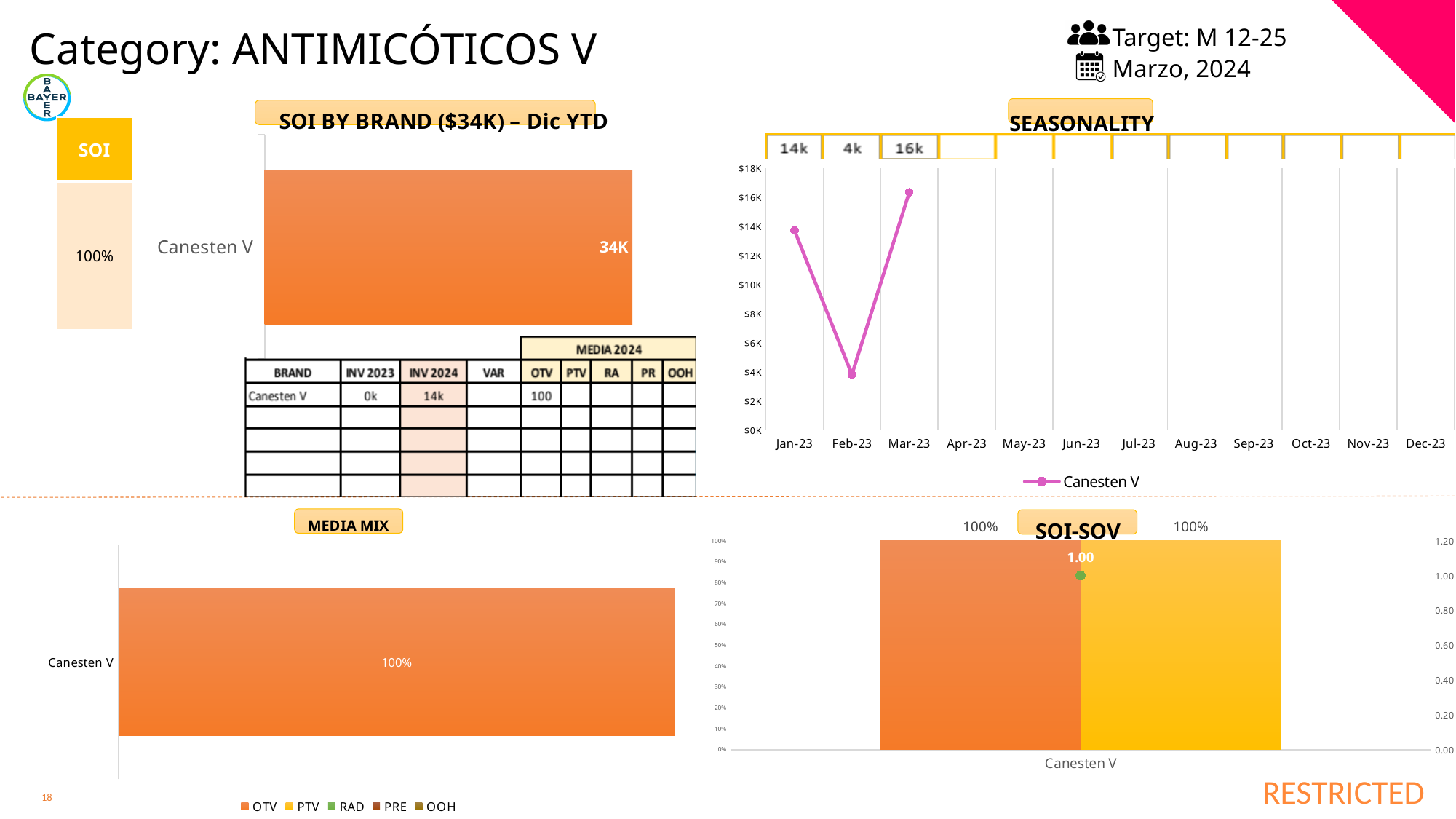
In the SOI BY BRAND chart, what is the value for Canesten V? 34K What kind of chart is the SEASONALITY chart? line chart In the SEASONALITY chart, is the value for Jan-23 greater or less than $12K? greater How many brands are plotted in the SOI BY BRAND chart? 1 What kind of chart is the SOI BY BRAND chart? bar chart In the SEASONALITY chart, what is the value for Canesten V in Mar-23? 16k In the MEDIA MIX chart, what is the value shown for Canesten V? 100% In the SEASONALITY chart, which month has the highest value for Canesten V? Mar-23 In the SEASONALITY chart, which month has the lowest value for Canesten V? Feb-23 In the SEASONALITY chart, what is the value for Canesten V in Feb-23? 4k How many series does the legend of the MEDIA MIX chart list? 5 In the SEASONALITY chart, does the line rise or fall from Feb-23 to Mar-23? rise